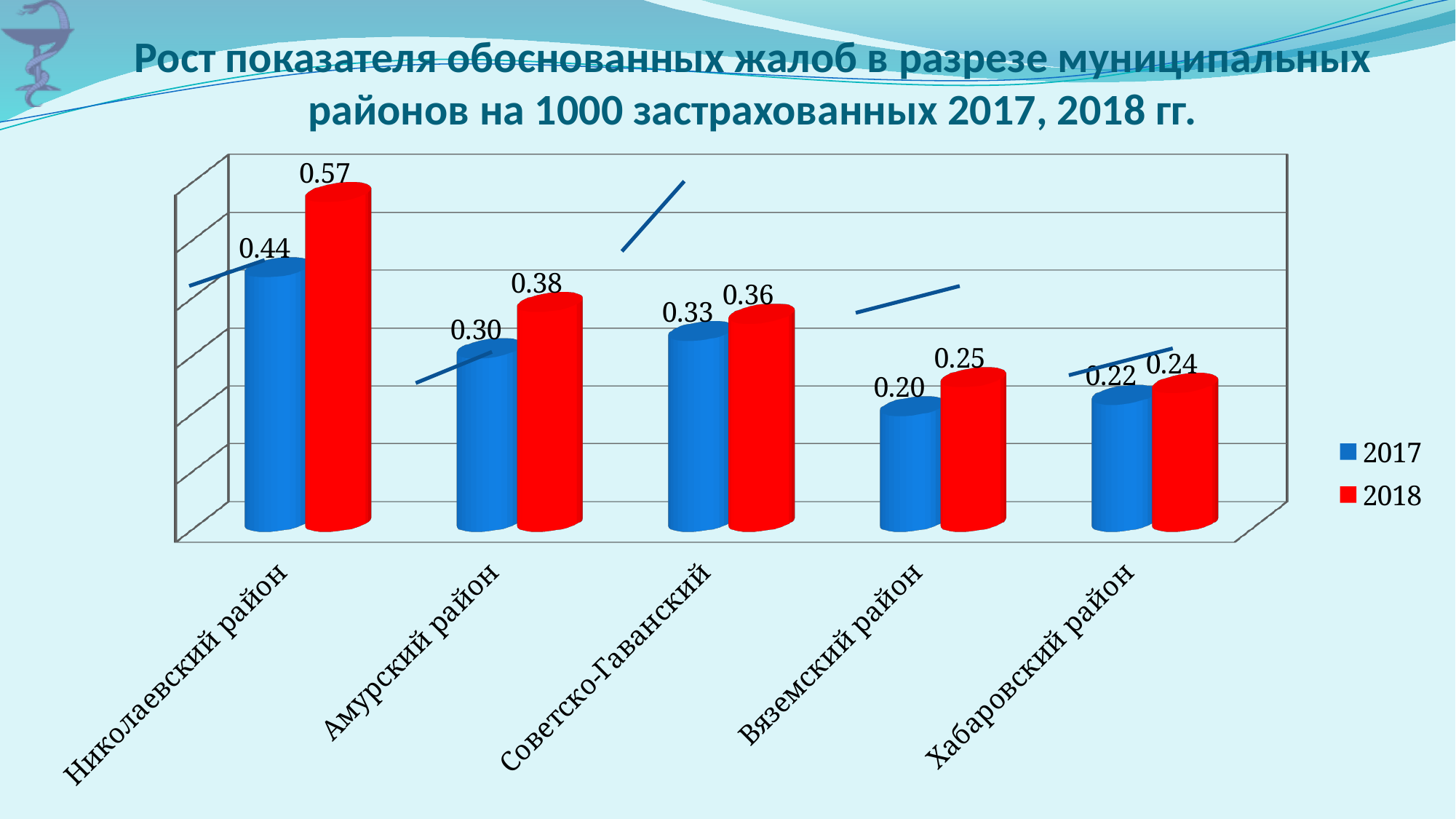
What is the 2018 value for Николаевский район? 0.57 Which is larger for Хабаровский район, the 2017 value or the 2018 value? 2018 How many series does the legend list? 2 What is the 2017 value for Амурский район? 0.30 What is the 2018 value for Советско-Гаванский? 0.36 What is the difference between the 2018 and 2017 values for Николаевский район? 0.13 What is the 2017 value for Вяземский район? 0.20 How many districts are shown on the x axis? 5 Which district has the lowest 2017 value? Вяземский район Which district has the highest 2018 value? Николаевский район Which colour represents the 2018 series in the legend? Red What kind of chart is shown on the slide? Bar chart